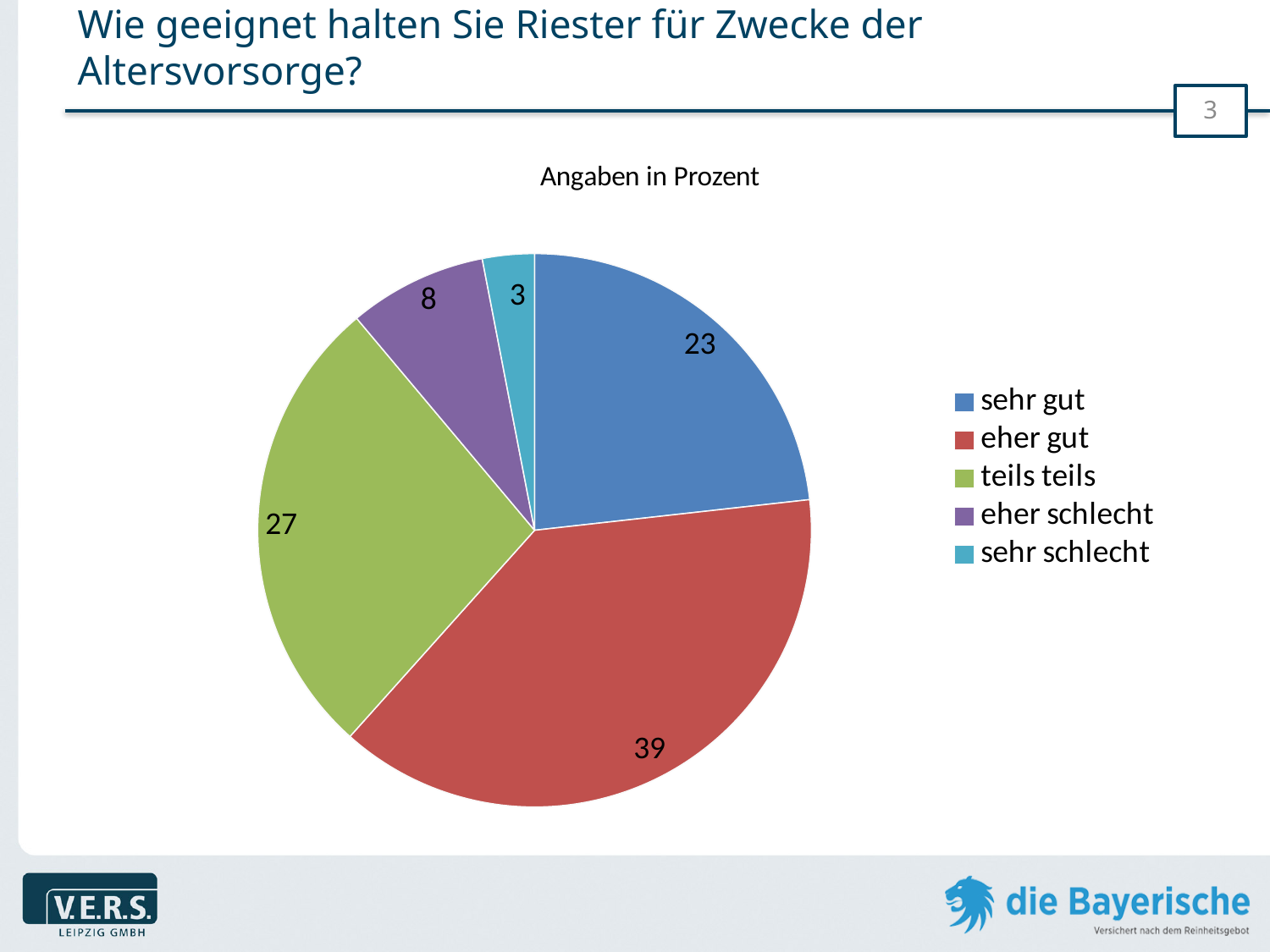
What is the value for "teils teils"? 27 What is the value for "eher gut"? 39 What type of chart is shown on the slide? pie chart What is the value for "sehr gut"? 23 What is the subtitle shown above the pie chart? Angaben in Prozent Which category has the smallest slice? sehr schlecht What is the value for "sehr schlecht"? 3 How many categories does the legend list? 5 Which is larger, the value for "teils teils" or the value for "sehr gut"? teils teils Which category has the largest slice? eher gut What is the value for "eher schlecht"? 8 What is the difference between the values for "eher gut" and "sehr gut"? 16